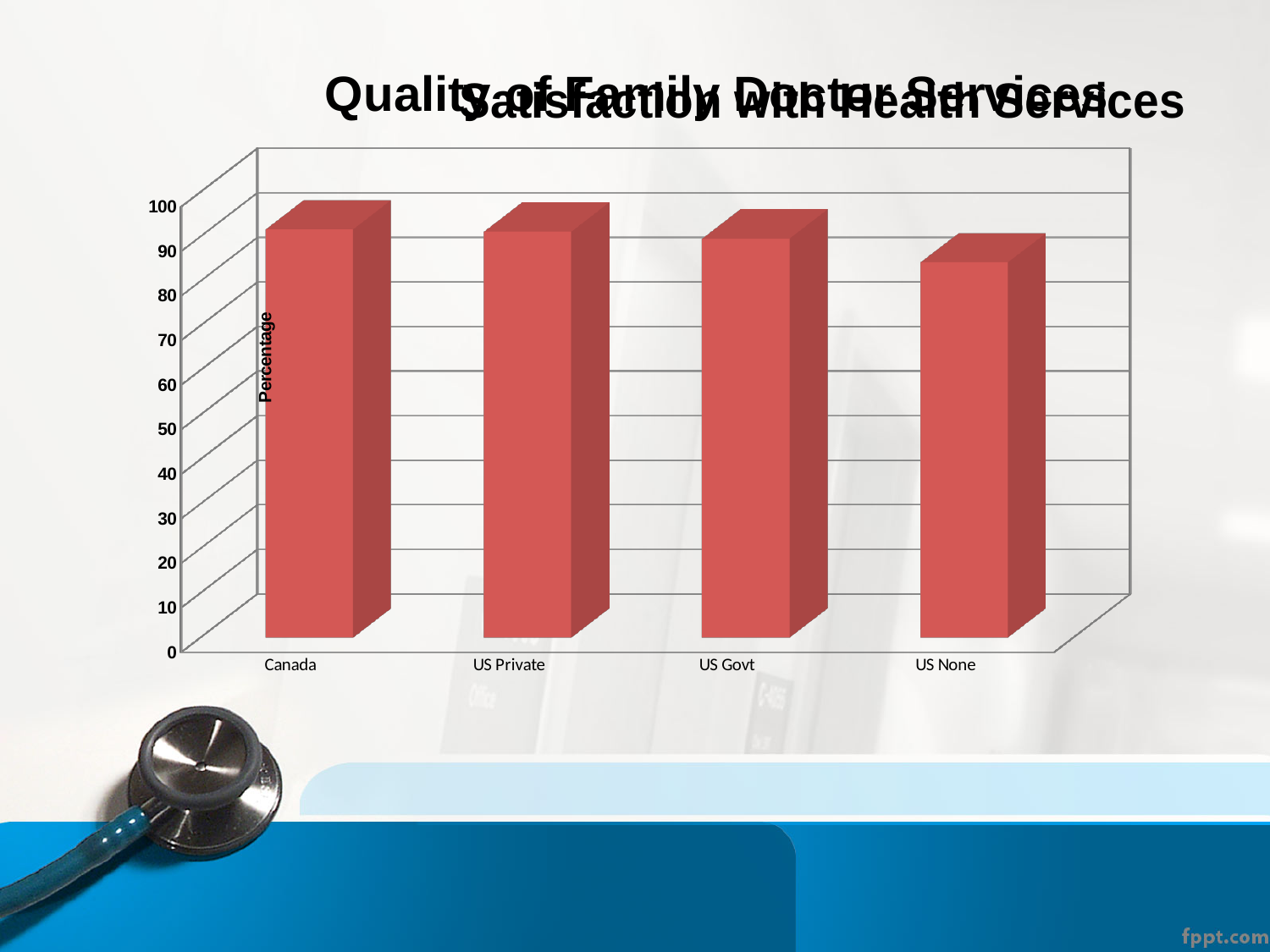
Is the value for US None greater or less than 70? greater Is the value for US Private greater or less than 60? greater What kind of chart is shown on the slide? bar chart Is the value for US None greater or less than 90? less Which is larger, the value for US Private or the value for US None? US Private How many categories are plotted on the x axis of the chart? 4 What is the label on the vertical axis of the chart? Percentage Do the bar values rise or fall moving from Canada on the left to US None on the right? fall Which category has the lowest bar in the chart? US None Which is larger, the value for Canada or the value for US None? Canada